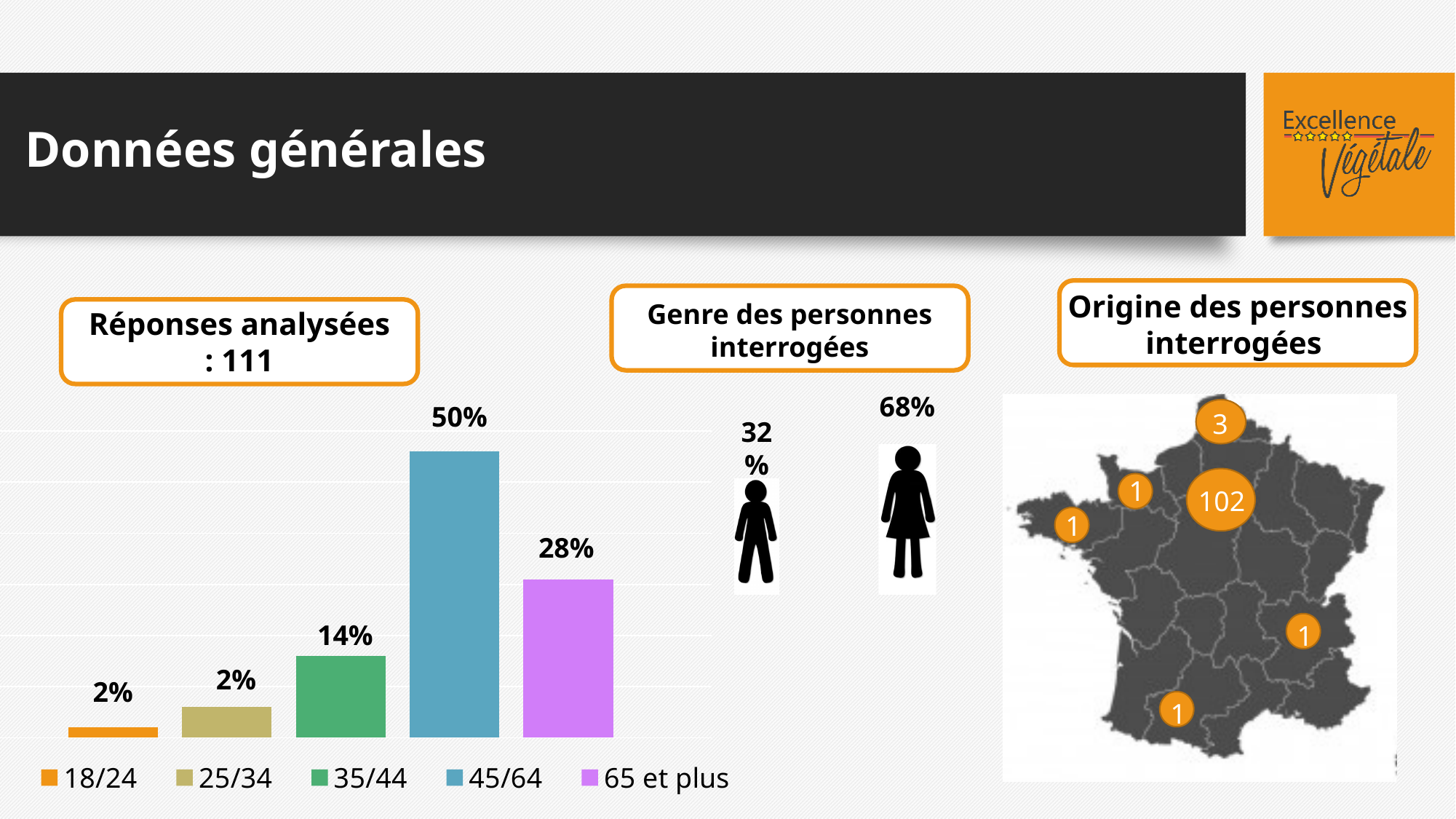
What type of chart is used on the left to show the age groups of respondents? Bar chart In the bar chart of age groups on the left, what is the value for the 18/24 category? 2% How many age-group categories are shown in the bar chart on the left? 5 In the bar chart of age groups on the left, what is the difference between the 35/44 and 25/34 values? 12% In the bar chart of age groups on the left, what is the difference between the 45/64 and 65 et plus values? 22% In the bar chart of age groups on the left, what is the value for the 35/44 category? 14% In the bar chart of age groups on the left, which age group has the highest value? 45/64 In the bar chart of age groups on the left, what is the value for the 65 et plus category? 28% In the bar chart of age groups on the left, which is larger, the value for 35/44 or the value for 65 et plus? 65 et plus How many entries does the legend of the bar chart on the left list? 5 In the bar chart of age groups on the left, what colour is the bar for the 45/64 category? Blue In the bar chart of age groups on the left, what is the value for the 45/64 category? 50%